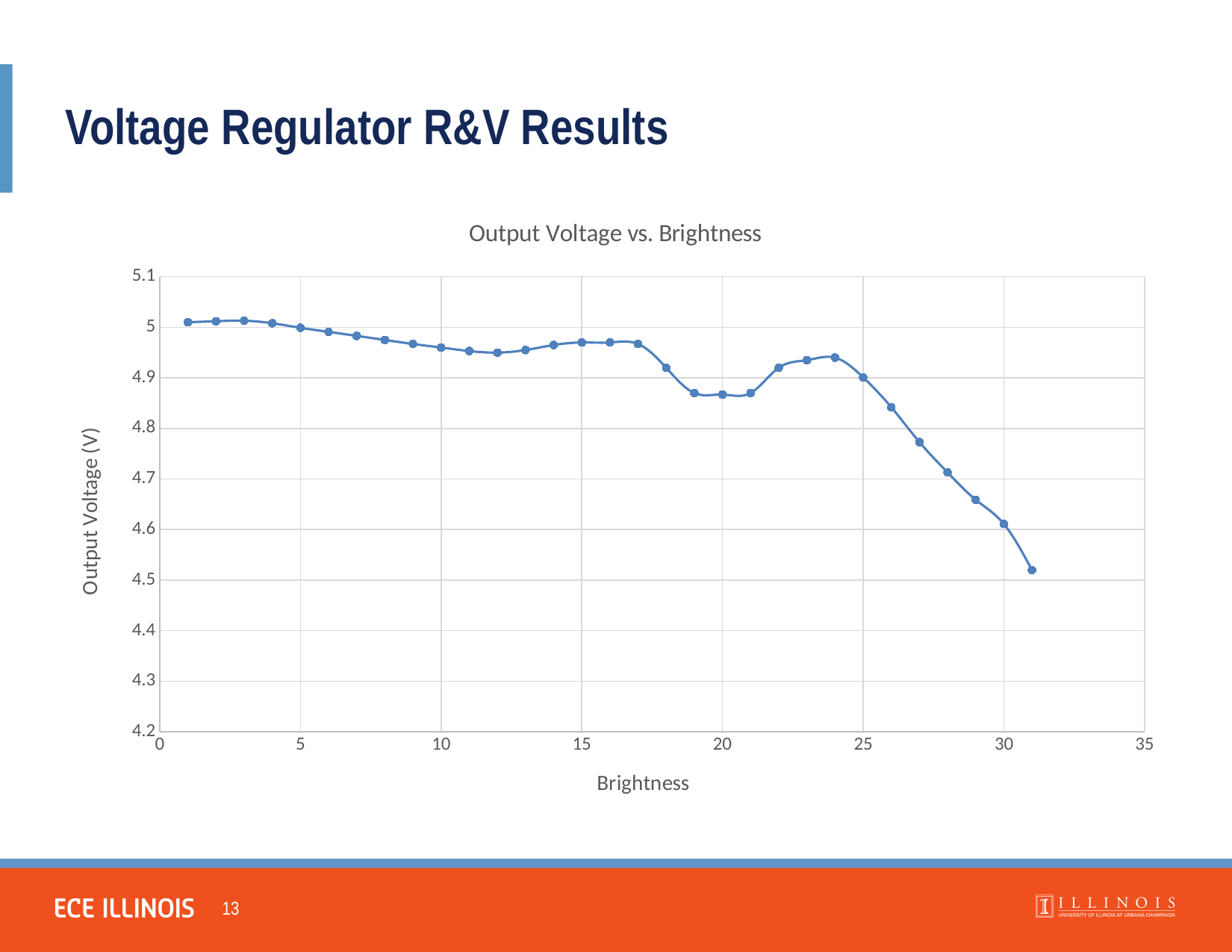
Overall, does the output voltage rise or fall as brightness increases? fall At which brightness value is the output voltage lowest? 31 Which has the higher output voltage: brightness 5 or brightness 30? brightness 5 Which has the higher output voltage: brightness 19 or brightness 24? brightness 24 Is the output voltage at brightness 27 greater or less than 4.8? less How many data points are plotted on the chart? 31 What is the title of the chart? Output Voltage vs. Brightness What is the label of the vertical axis? Output Voltage (V) Is the output voltage at brightness 31 greater or less than 4.6? less What kind of chart is shown on the slide? line chart Is the output voltage at brightness 20 greater or less than 4.9? less